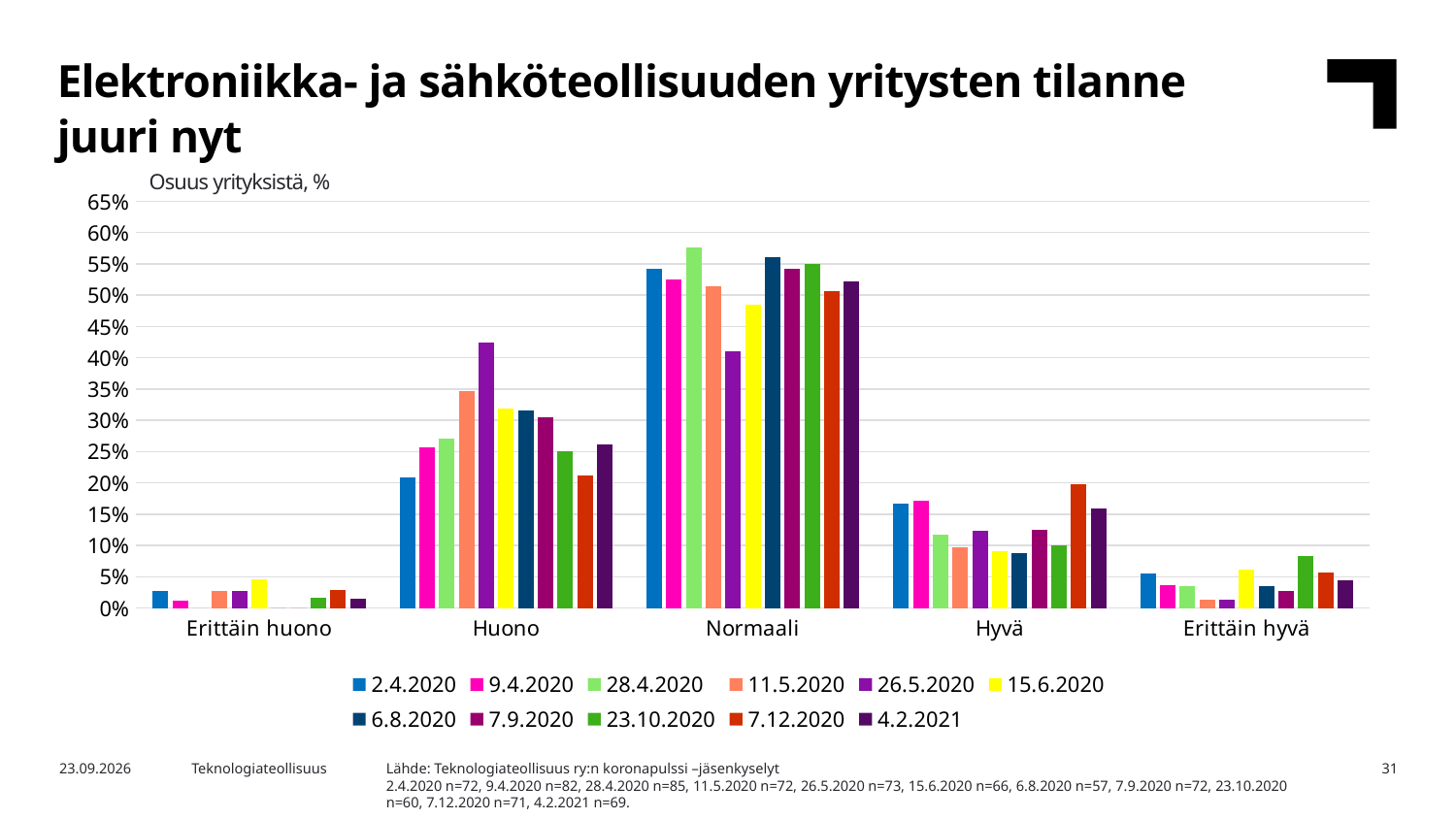
Which series has the lowest bar in the Normaali category? 26.5.2020 Is the value for 26.5.2020 in the Huono category greater or less than 40%? greater Is the value for 26.5.2020 in the Normaali category greater or less than 45%? less What kind of chart is shown on the slide? bar chart Which series has the highest bar in the Hyvä category? 7.12.2020 In the Normaali category, which is larger: the value for 15.6.2020 or the value for 7.9.2020? 7.9.2020 How many categories are shown on the x axis? 5 Which series has the highest bar in the Erittäin hyvä category? 23.10.2020 What is the label on the vertical axis of the chart? Osuus yrityksistä, % Is the value for 7.12.2020 in the Hyvä category greater or less than 15%? greater Which series has the highest bar in the Huono category? 26.5.2020 How many series does the legend list? 11